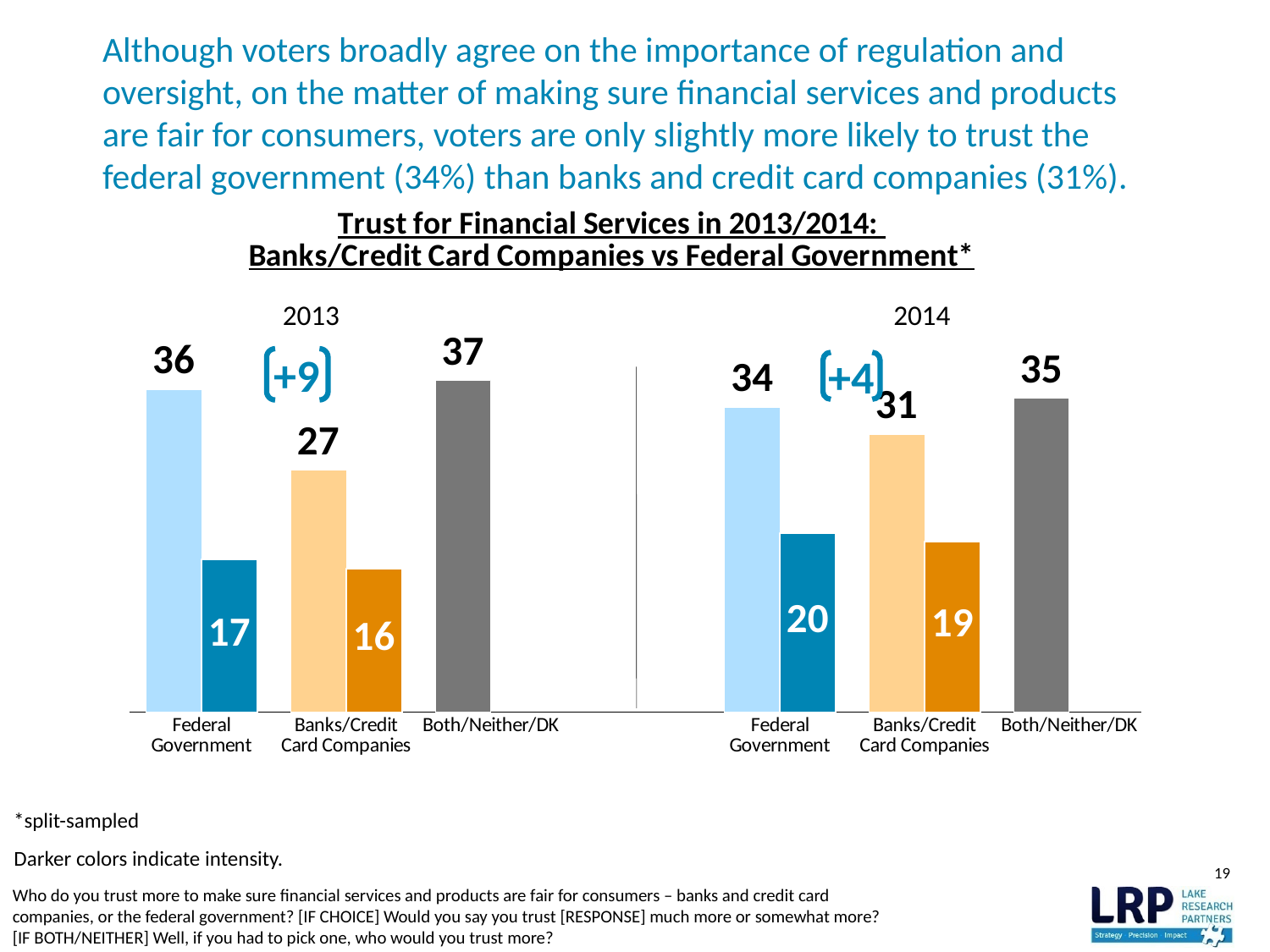
How many categories are shown on the x axis of the 2013 chart? 3 In the 2013 chart, what is the difference between the light bar for Federal Government and the light bar for Banks/Credit Card Companies? 9 In the 2014 chart, what is the value for Both/Neither/DK? 35 In the 2014 chart, what is the value of the dark bar for Federal Government? 20 In the 2014 chart, what is the difference between the light bar for Federal Government and the light bar for Banks/Credit Card Companies? 3 In the 2013 chart, which is larger: the dark bar for Federal Government or the dark bar for Banks/Credit Card Companies? Federal Government In the 2014 chart, what is the value of the dark bar for Banks/Credit Card Companies? 19 What kind of chart is used on this slide? Bar chart In the 2013 chart, what is the value of the light bar for Federal Government? 36 In the 2013 chart, what is the value of the light bar for Banks/Credit Card Companies? 27 In the 2014 chart, which category has the highest value? Both/Neither/DK In the 2013 chart, what is the value for Both/Neither/DK? 37